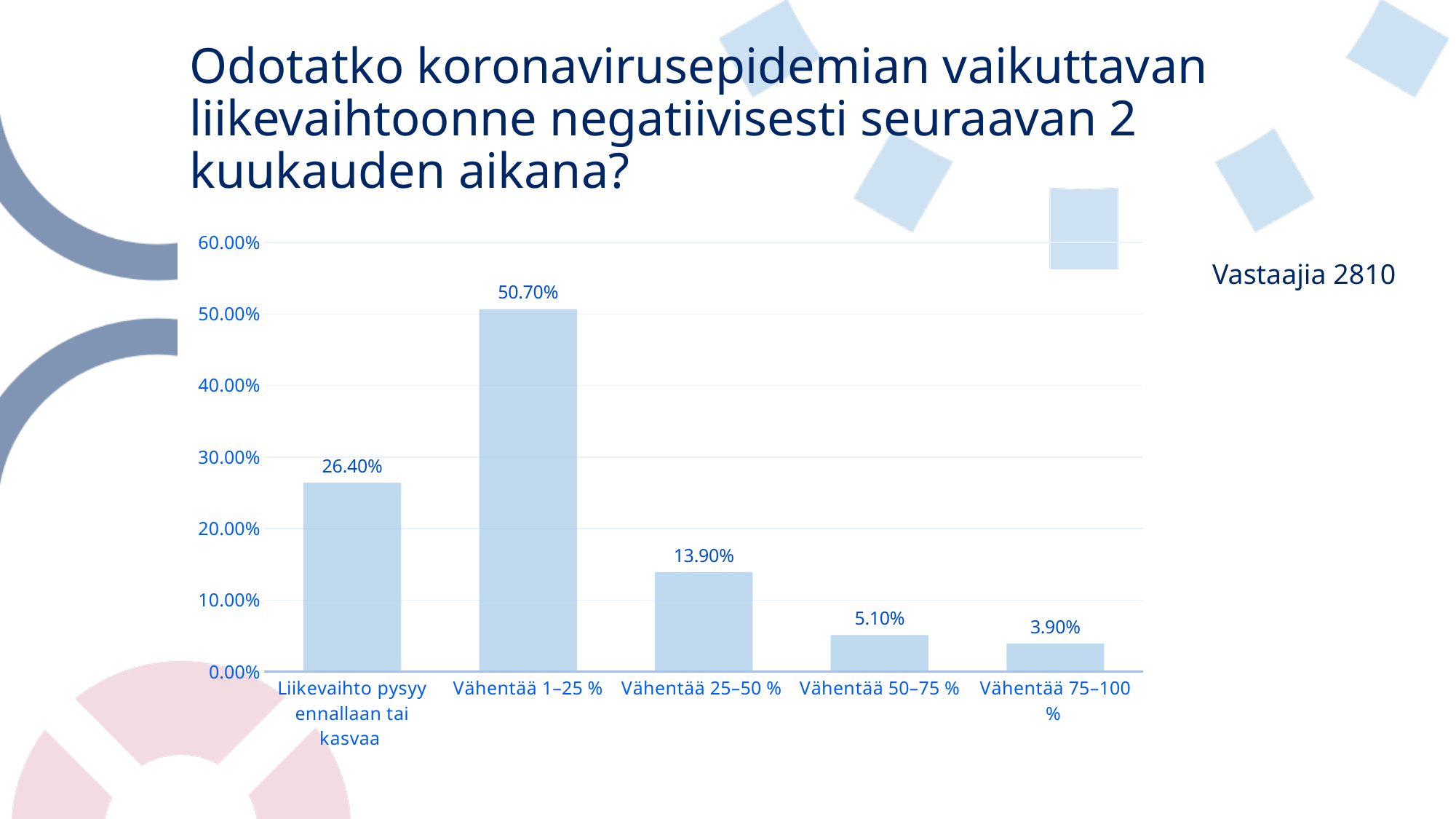
Which is larger, the value for "Vähentää 50–75 %" or "Vähentää 75–100 %"? Vähentää 50–75 % How many respondents (Vastaajia) does the slide report? 2810 Which category has the highest value? Vähentää 1–25 % How many categories are shown on the x axis? 5 Is the value for "Vähentää 25–50 %" greater or less than 20.00%? less What is the difference between the values for "Vähentää 1–25 %" and "Vähentää 25–50 %"? 36.80% What is the difference between the values for "Vähentää 50–75 %" and "Vähentää 75–100 %"? 1.20% Which category has the lowest value? Vähentää 75–100 % What is the value for "Vähentää 75–100 %"? 3.90% What is the value for "Vähentää 1–25 %"? 50.70% What is the value for "Liikevaihto pysyy ennallaan tai kasvaa"? 26.40% What kind of chart is shown on the slide? bar chart